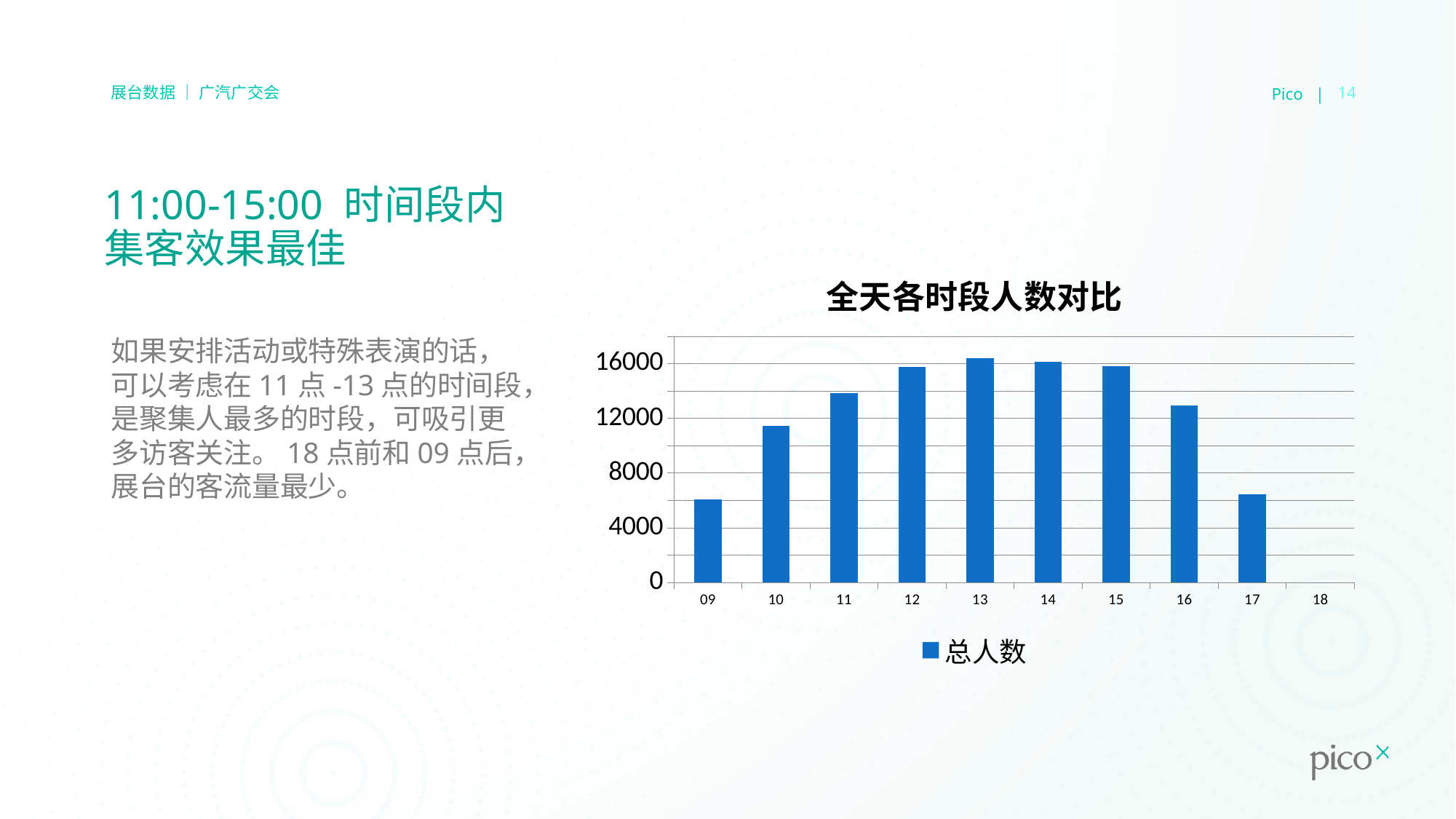
Is the value for 16 greater or less than 12000? greater How many series does the chart legend list? 1 What is the name of the series shown in the legend? 总人数 What is the title of the chart? 全天各时段人数对比 Is the value for 11 greater or less than 12000? greater Do the values rise or fall from 13 to 17 along the x axis? fall How many time-slot categories are shown on the x axis? 10 What kind of chart is shown on the slide? bar chart Is the value for 17 greater or less than 8000? less Which has a larger value, 09 or 10? 10